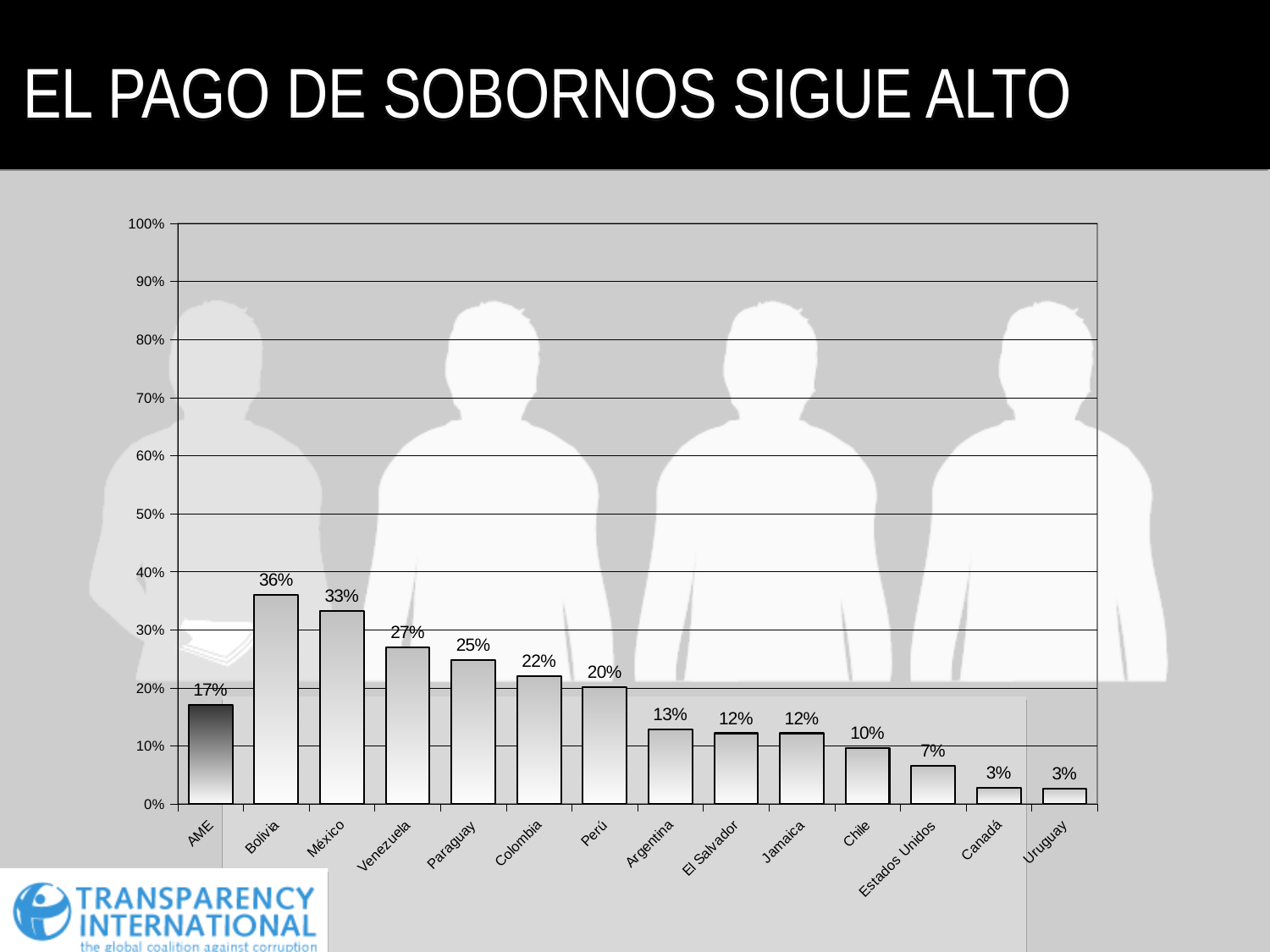
Do the values rise or fall from Bolivia to Uruguay along the x axis? fall What kind of chart is shown on the slide? bar chart What is the difference between the values for Bolivia and México? 3% What is the difference between the values for Venezuela and Perú? 7% Which category has the highest value? Bolivia Is the value for Chile greater or less than 20%? less What is the value for Bolivia? 36% What is the value for Estados Unidos? 7% How many categories are shown on the x axis? 14 Which is larger, the value for Paraguay or the value for Colombia? Paraguay What is the value for AME? 17% What is the title of the slide? EL PAGO DE SOBORNOS SIGUE ALTO